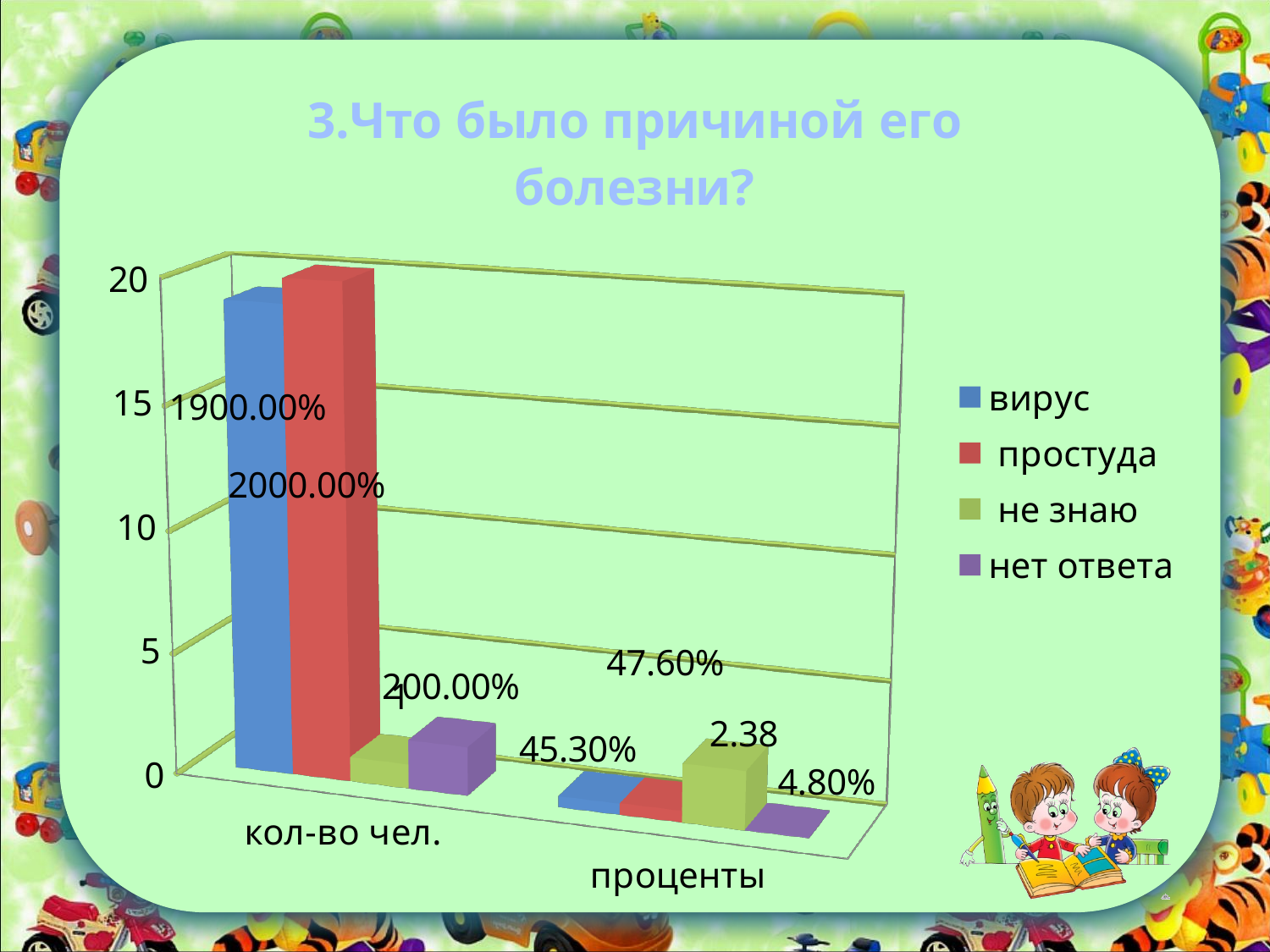
What is the data label for простуда in the кол-во чел. category? 2000.00% Is the bar for вирус in the кол-во чел. category greater or less than 15 on the axis? greater What is the data label for вирус in the кол-во чел. category? 1900.00% What is the data label for простуда in the проценты category? 47.60% Which series has the tallest bar in the кол-во чел. category? простуда How many series does the legend list? 4 What kind of chart is shown on the slide? bar chart What is the data label for нет ответа in the проценты category? 4.80% What is the data label for вирус in the проценты category? 45.30% Which series is shown in red in the legend? простуда What is the title of the chart? 3.Что было причиной его болезни? How many categories are shown on the x axis? 2